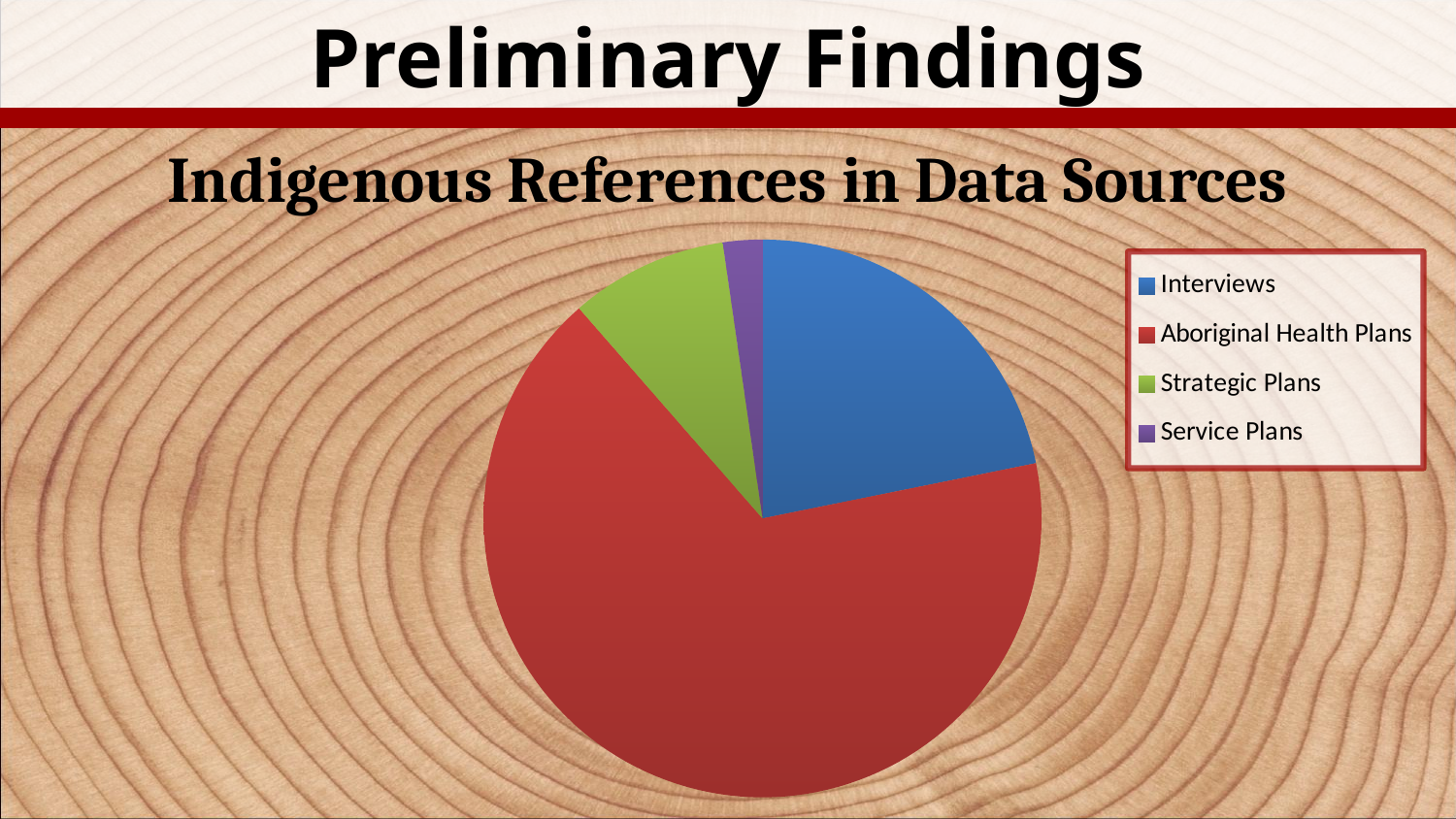
Which slice is larger, Aboriginal Health Plans or Interviews? Aboriginal Health Plans What colour is the slice for Aboriginal Health Plans? red Does the Aboriginal Health Plans slice take up more or less than half of the pie? more Which slice is larger, Interviews or Strategic Plans? Interviews Which category has the smallest slice of the pie? Service Plans Which slice is larger, Strategic Plans or Service Plans? Strategic Plans What is the title of the chart? Indigenous References in Data Sources Which category has the largest slice of the pie? Aboriginal Health Plans How many categories does the legend list? 4 What kind of chart is shown on the slide? pie chart